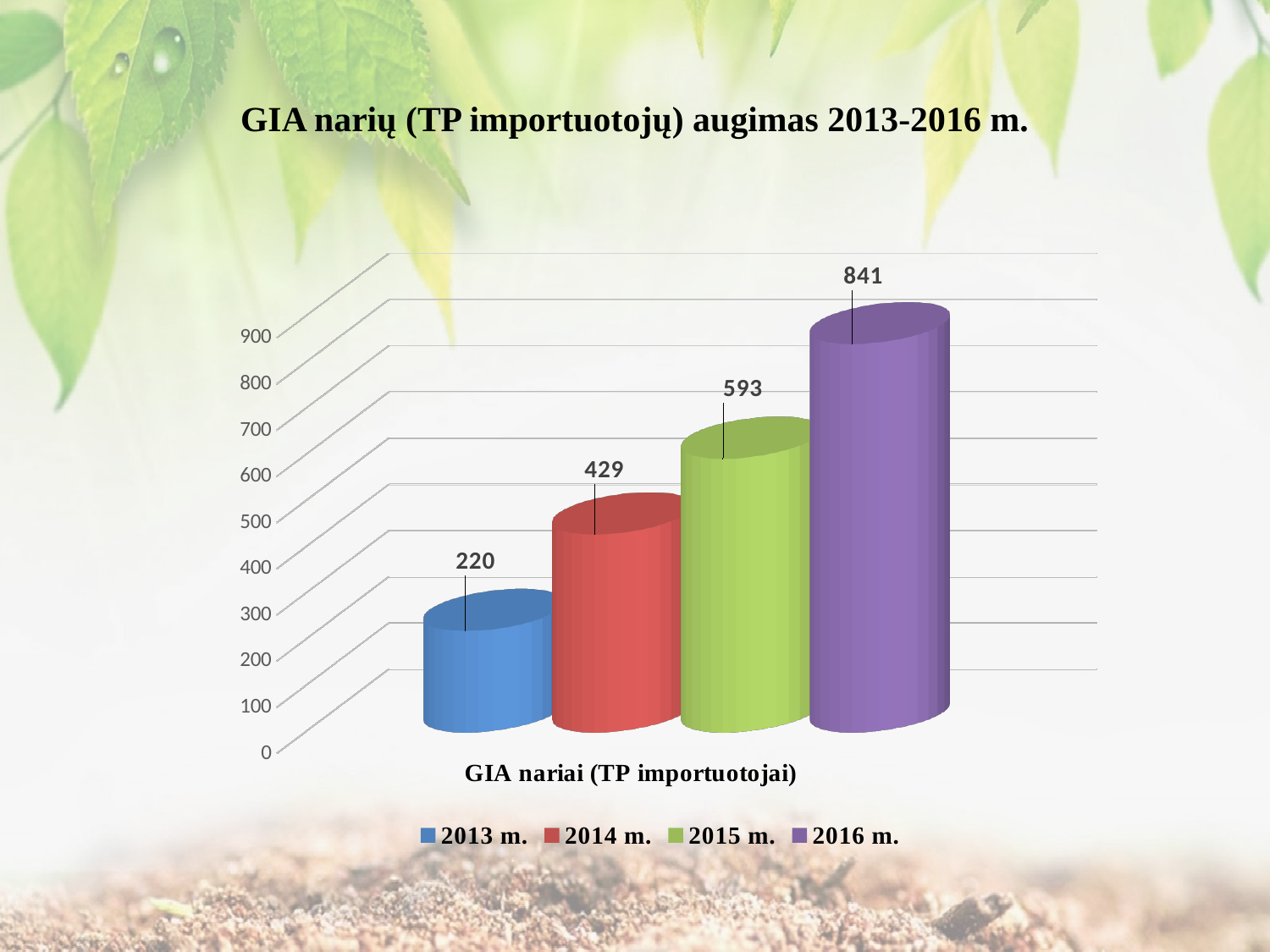
What is the difference between the values for 2015 m. and 2014 m.? 164 What is the value for 2016 m.? 841 Which year has the highest value? 2016 m. What is the value for 2013 m.? 220 How many series does the legend list? 4 Do the values rise or fall from 2013 m. to 2016 m.? Rise Which is larger, the value for 2014 m. or the value for 2015 m.? 2015 m. What kind of chart is shown on the slide? Bar chart What is the value for 2015 m.? 593 Which year has the lowest value? 2013 m. What is the difference between the values for 2016 m. and 2013 m.? 621 What is the value for 2014 m.? 429